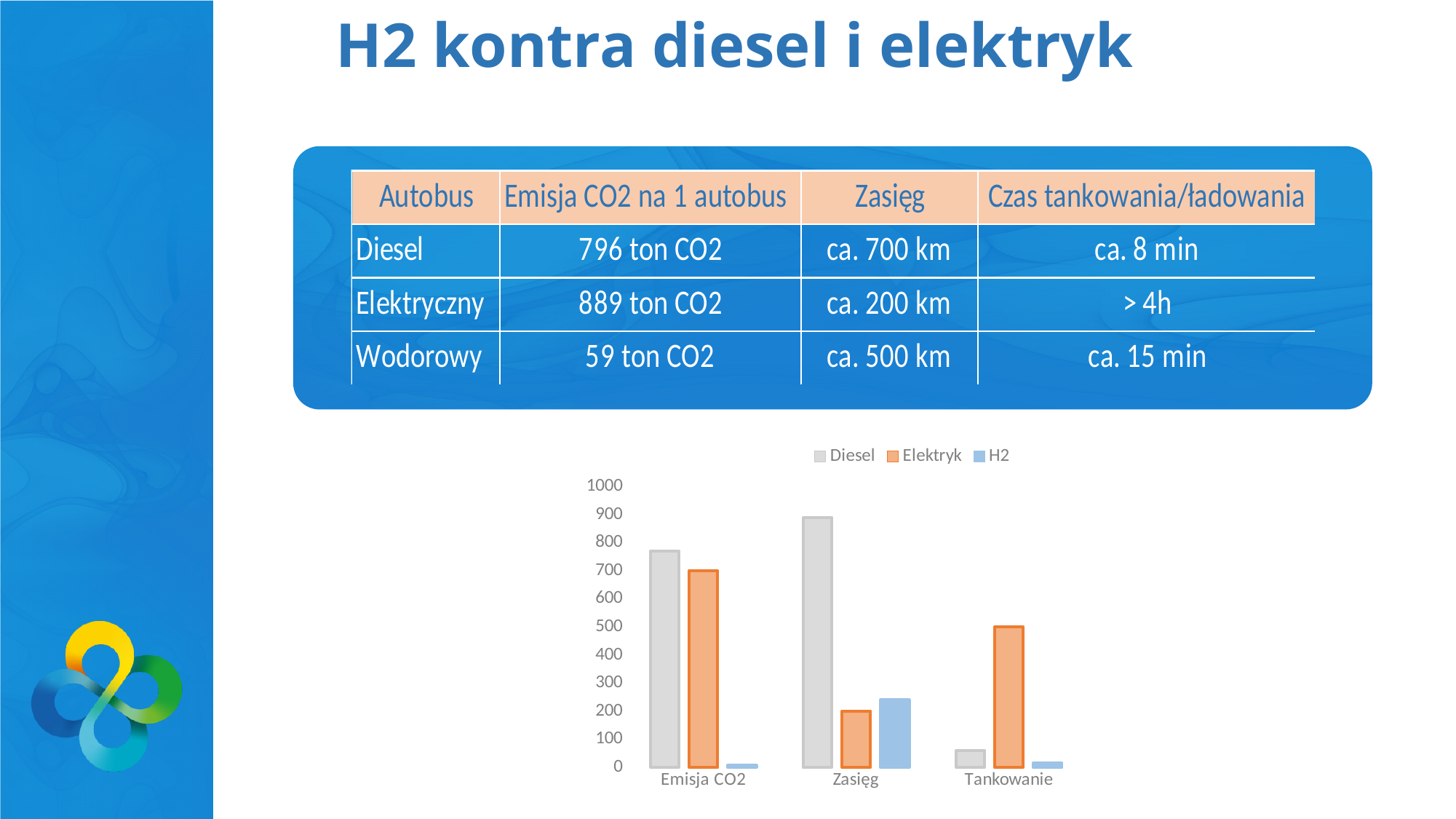
How many categories are shown on the x axis of the chart? 3 Is the Diesel value for Zasięg greater or less than 800? greater How many series does the chart legend list? 3 Which series has the lowest bar in the Emisja CO2 category? H2 In the Emisja CO2 category, which is larger: the Diesel bar or the Elektryk bar? Diesel Is the Diesel value for Tankowanie greater or less than 100? less Which series has the highest bar in the Zasięg category? Diesel What are the entries listed in the chart legend? Diesel, Elektryk, H2 Which series has the highest bar in the Tankowanie category? Elektryk What kind of chart is shown on the slide? bar chart In the Zasięg category, which is larger: the H2 bar or the Elektryk bar? H2 Is the Elektryk value for Tankowanie greater or less than 400? greater